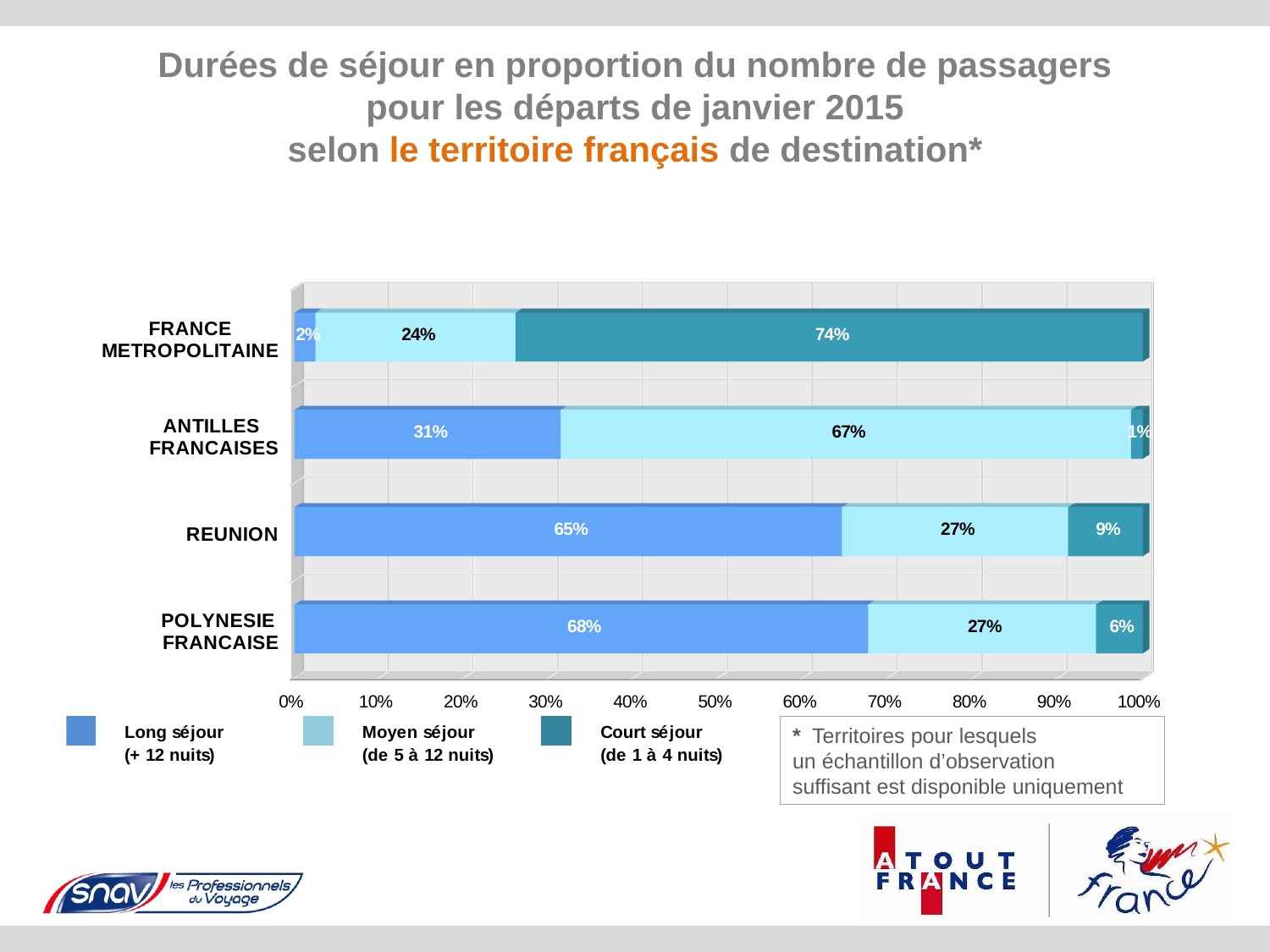
Which is larger: the Moyen séjour share for France Métropolitaine or for Réunion? Réunion What is the Moyen séjour (de 5 à 12 nuits) share for Antilles Françaises? 67% How many series does the legend list? 3 What is the Court séjour share for Polynésie Française? 6% Which series is represented by the darkest blue colour in the legend? Court séjour (de 1 à 4 nuits) What type of chart is shown on the slide? Stacked bar chart What is the difference between the Long séjour shares of Polynésie Française and Réunion? 3% What is the Court séjour (de 1 à 4 nuits) share for France Métropolitaine? 74% Which territory has the highest Long séjour (+ 12 nuits) share? Polynésie Française How many territories (categories) are shown in the chart? 4 Which territory has the lowest Court séjour (de 1 à 4 nuits) share? Antilles Françaises What is the Long séjour (+ 12 nuits) share for Réunion? 65%